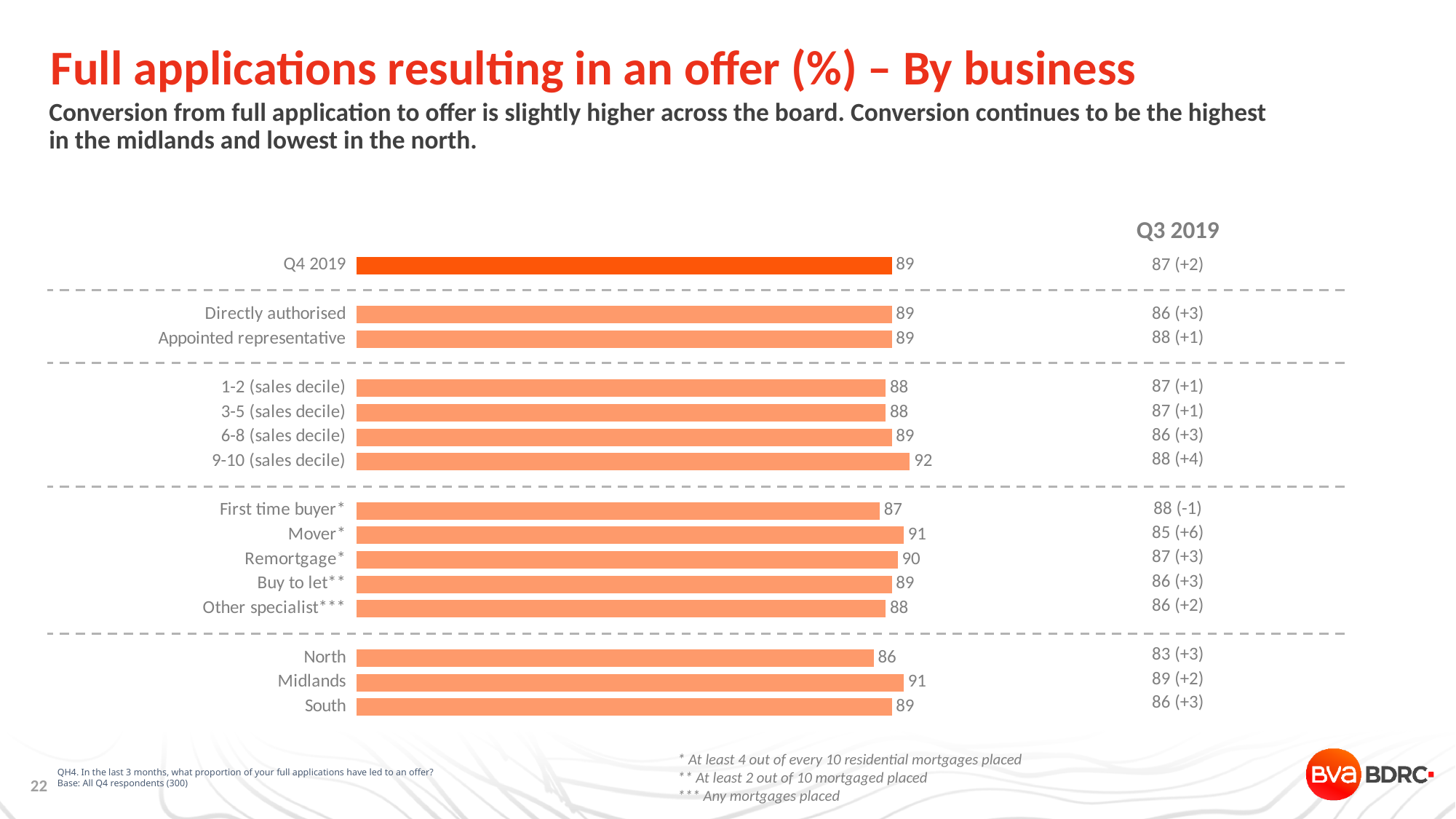
What is the Q3 2019 figure shown for North in the column to the right of the chart? 83 (+3) What is the Q4 2019 value for Mover? 91 What is the Q4 2019 value for the 9-10 (sales decile) bar? 92 Which is larger, the value for First time buyer or the value for Mover? Mover What is the difference between the Midlands value and the North value? 5 Which category has the lowest bar in the chart? North How many bars are plotted in the chart? 15 What is the Q4 2019 value for Remortgage? 90 What type of chart is shown on the slide? bar chart What is the difference between the 9-10 (sales decile) value and the 1-2 (sales decile) value? 4 What is the Q4 2019 value for North? 86 Which category has the highest bar in the chart? 9-10 (sales decile)